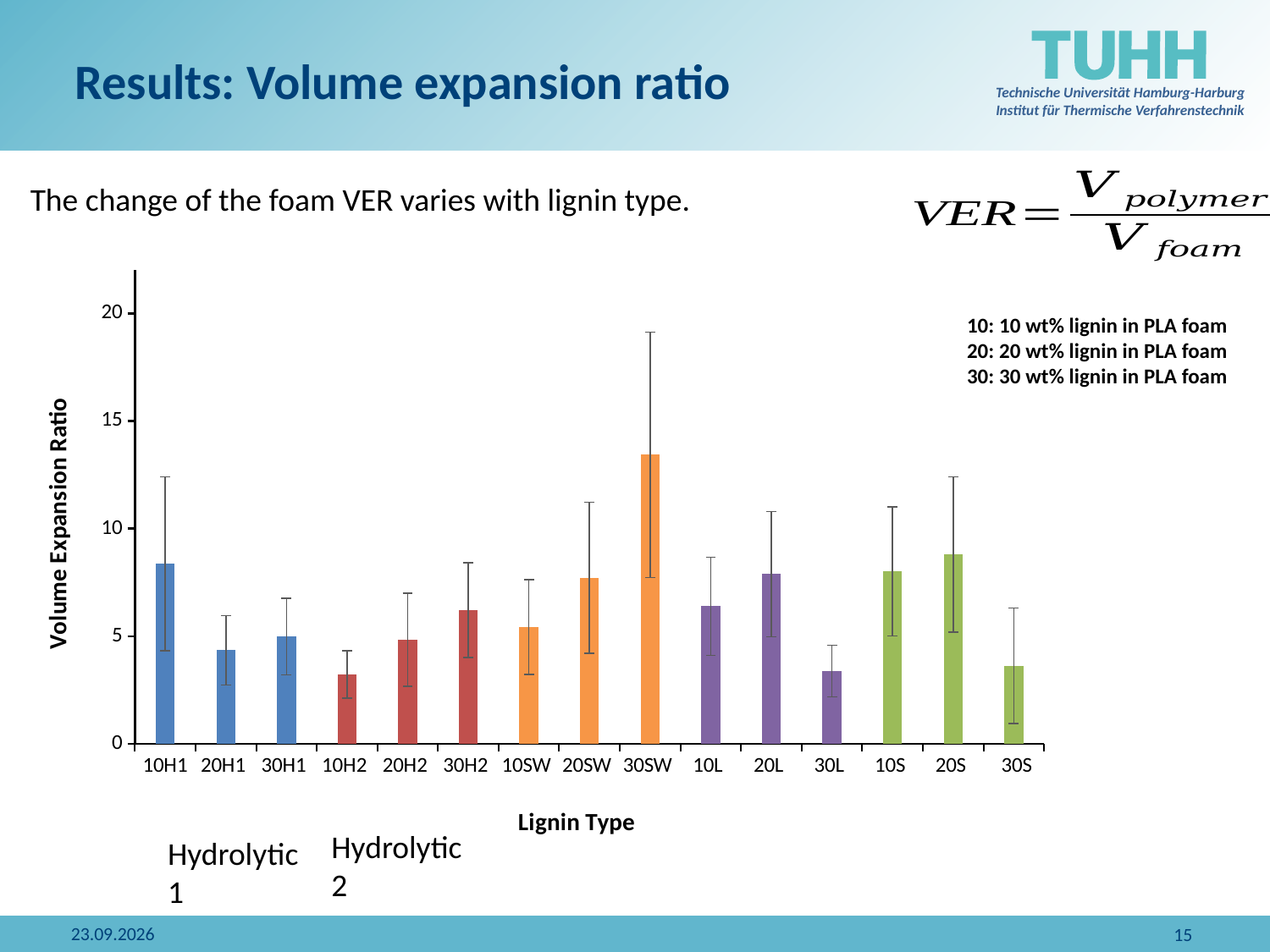
Is the value for 20S greater or less than 10? less What kind of chart is shown on the slide? bar chart Which has a larger volume expansion ratio, 20L or 30L? 20L What is the title of the y axis? Volume Expansion Ratio Is the value for 30SW greater or less than 10? greater How many lignin type categories are plotted on the x axis? 15 Is the value for 10H1 greater or less than 5? greater Which lignin type has the highest volume expansion ratio? 30SW Do the values rise or fall from 10SW to 30SW? rise What is the title of the x axis? Lignin Type Which has a larger volume expansion ratio, 10H1 or 20H1? 10H1